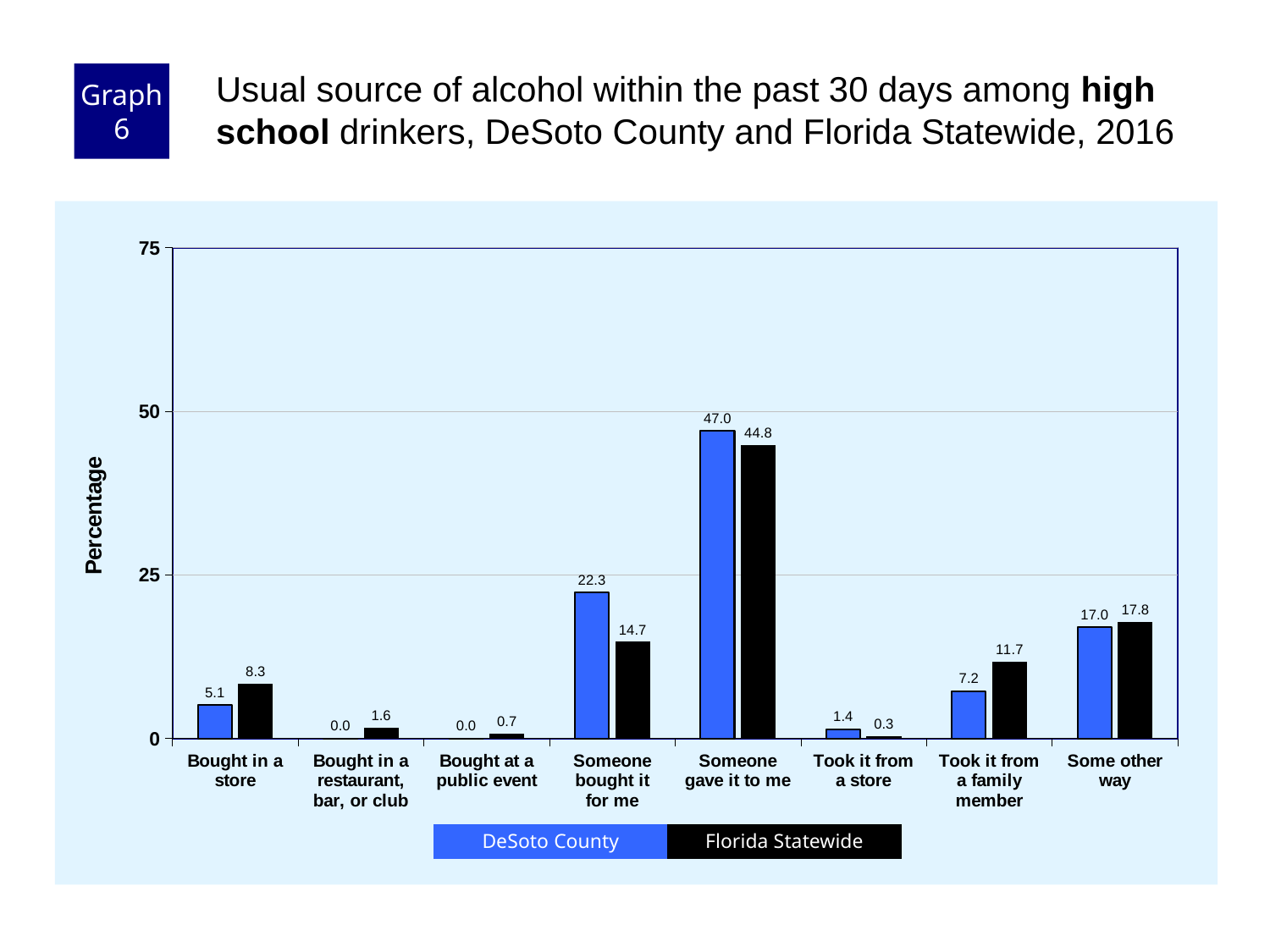
How many categories are shown on the x axis? 8 What kind of chart is shown on the slide? bar chart What is the difference between the Florida Statewide and DeSoto County values for "Bought in a store"? 3.2 What is the Florida Statewide value for "Someone bought it for me"? 14.7 How many series does the legend list? 2 Which category has the lowest Florida Statewide value? Took it from a store What is the DeSoto County value for "Someone gave it to me"? 47.0 What is the difference between the DeSoto County and Florida Statewide values for "Someone bought it for me"? 7.6 Is the DeSoto County value for "Someone bought it for me" greater or less than 25? less What is the Florida Statewide value for "Took it from a family member"? 11.7 Which is larger for "Some other way": DeSoto County or Florida Statewide? Florida Statewide Which category has the highest DeSoto County value? Someone gave it to me